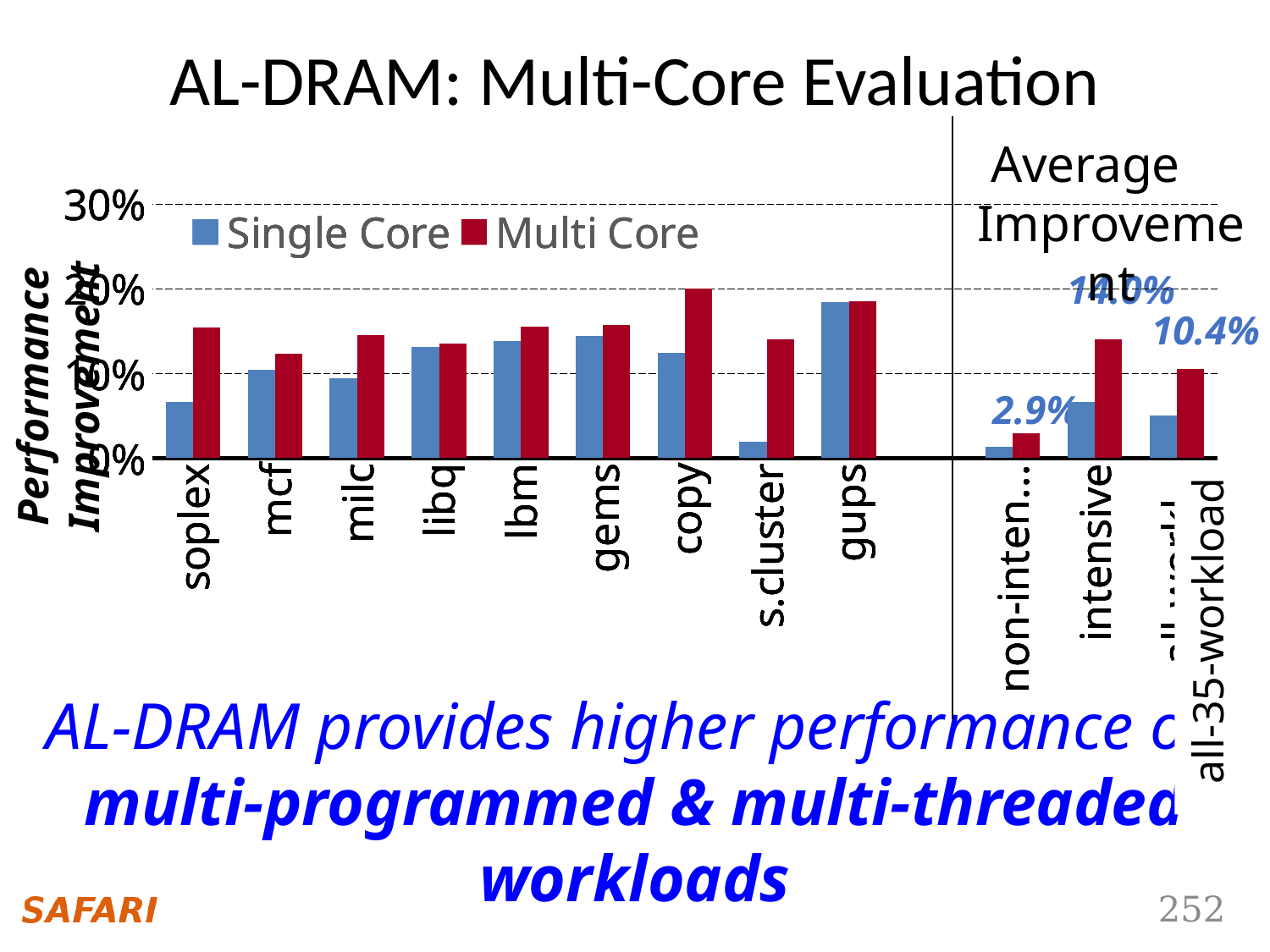
Is the Single Core value for gups greater or less than 10%? greater How many benchmark categories are plotted to the left of the vertical divider line? 9 What is the labelled Multi Core value for the all-35-workload category? 10.4% Which benchmark to the left of the divider has the lowest Single Core performance improvement? s.cluster Which benchmark to the left of the divider has the highest Single Core performance improvement? gups What kind of chart is shown on the slide? bar chart What are the two series named in the legend? Single Core and Multi Core Is the Single Core value for s.cluster greater or less than 10%? less For soplex, which is larger: the Single Core or the Multi Core bar? Multi Core What is the labelled value shown above the non-intensive bars? 2.9% For s.cluster, which is larger: the Single Core or the Multi Core bar? Multi Core How many series does the legend list? 2